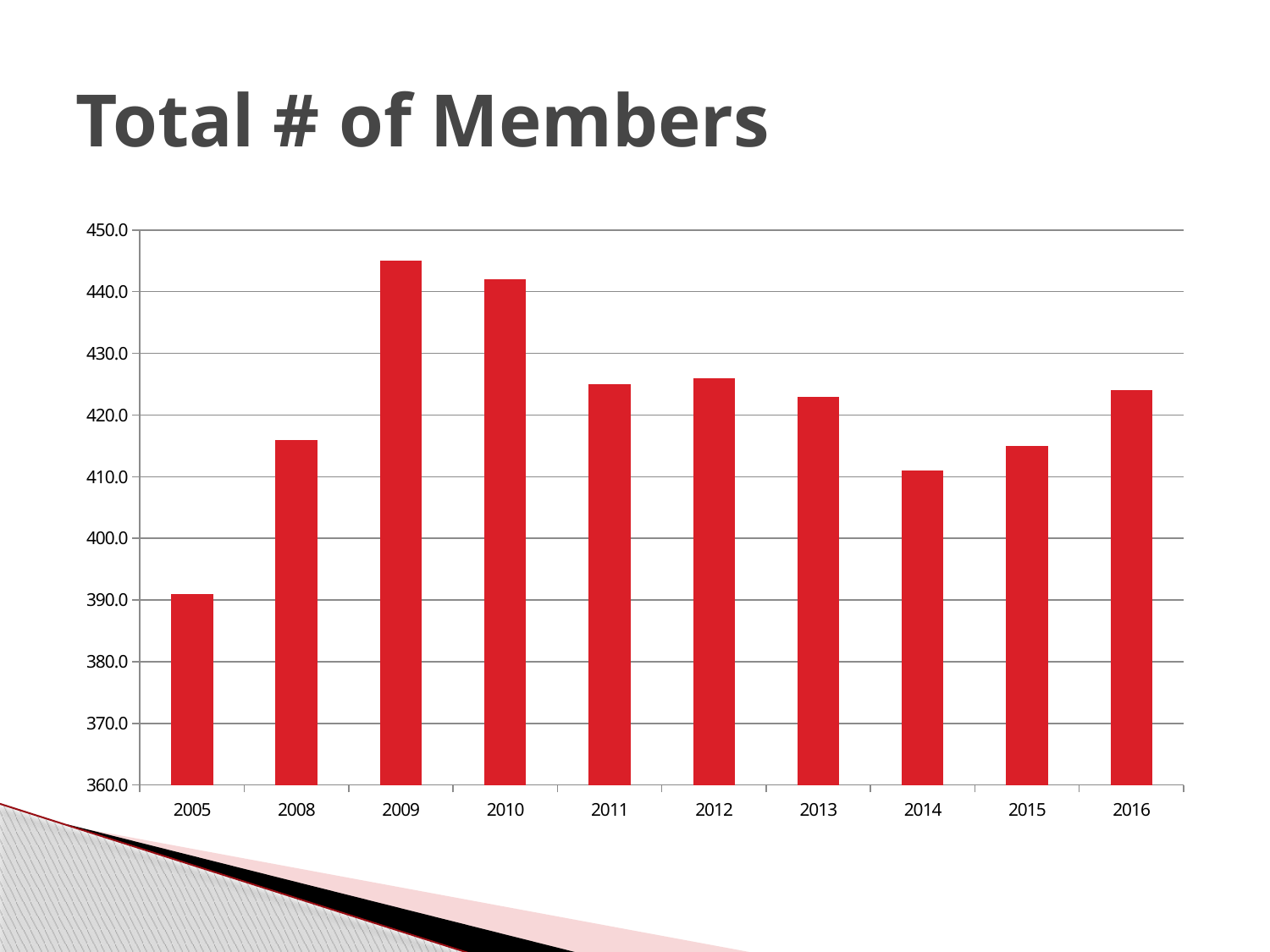
Which year has more members, 2005 or 2008? 2008 What is the title of the chart? Total # of Members Is the value for 2009 greater or less than 440.0? greater Which year has more members, 2010 or 2011? 2010 Is the value for 2014 greater or less than 420.0? less Do the values rise or fall from 2010 to 2014? fall Is the value for 2005 greater or less than 400.0? less What kind of chart is shown on the slide? bar chart Which year has the lowest total number of members? 2005 Which year has the highest total number of members? 2009 How many years are shown on the x axis of the chart? 10